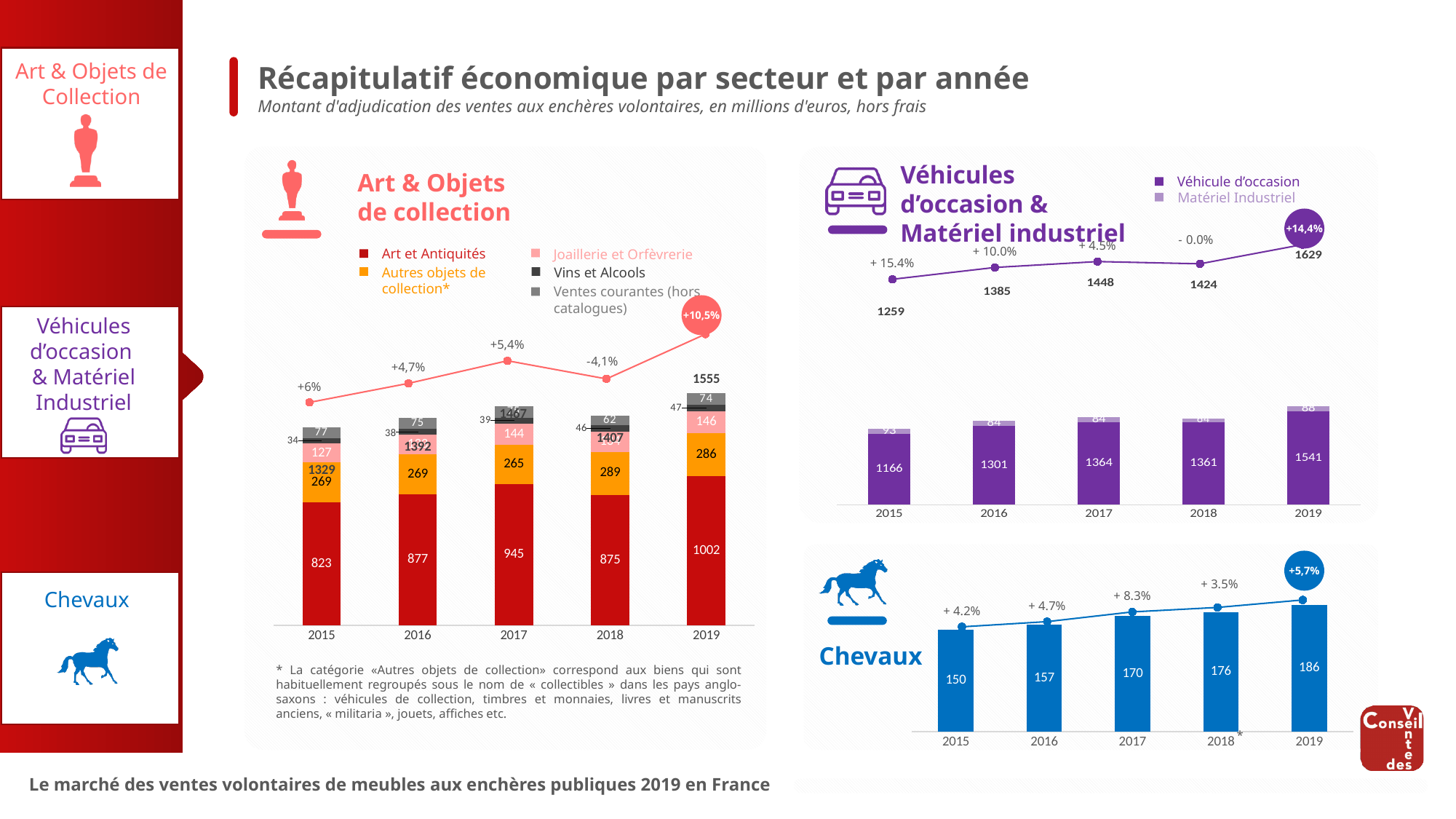
In the Art & Objets de collection chart, how many series does the legend list? 5 In the Art & Objets de collection chart, which year has the highest Art et Antiquités value? 2019 In the Art & Objets de collection chart, what is the total of the stacked bar for 2019? 1555 In the Véhicules d'occasion & Matériel industriel chart, is the Véhicule d'occasion value for 2019 larger or smaller than the value for 2018? larger In the Art & Objets de collection chart, what is the value for Art et Antiquités in 2019? 1002 In the Chevaux chart, how many years are shown on the x axis? 5 In the Chevaux chart, what is the value for 2019? 186 In the Chevaux chart, do the values rise or fall from 2015 to 2019? rise In the Véhicules d'occasion & Matériel industriel chart, what is the Véhicule d'occasion value for 2017? 1364 In the Chevaux chart, what is the difference between the 2019 and 2015 values? 36 In the Chevaux chart, which year has the lowest value? 2015 In the Art & Objets de collection chart, what percentage change is shown for 2018? -4,1%